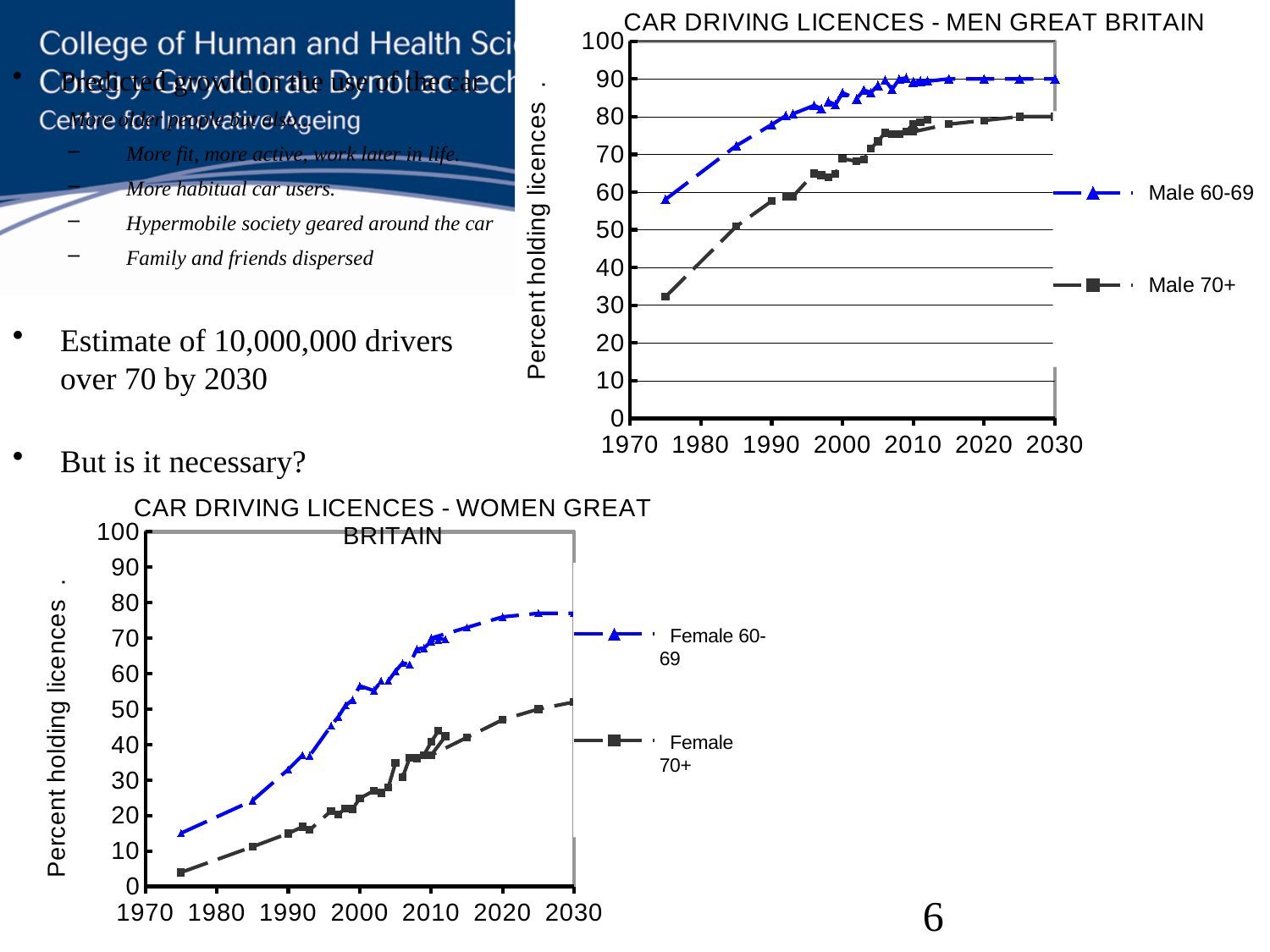
In the 'CAR DRIVING LICENCES - MEN GREAT BRITAIN' chart, is the value for Male 70+ in 1975 greater or less than 40? less In the 'CAR DRIVING LICENCES - MEN GREAT BRITAIN' chart, which series has the higher value in 2030, Male 60-69 or Male 70+? Male 60-69 What is the y-axis label of the 'CAR DRIVING LICENCES - WOMEN GREAT BRITAIN' chart? Percent holding licences In the 'CAR DRIVING LICENCES - WOMEN GREAT BRITAIN' chart, is the value for Female 60-69 in 2030 greater or less than 70? greater In the 'CAR DRIVING LICENCES - MEN GREAT BRITAIN' chart, is the value for Male 60-69 in 1975 greater or less than 50? greater In the 'CAR DRIVING LICENCES - WOMEN GREAT BRITAIN' chart, how many series does the legend list? 2 In the 'CAR DRIVING LICENCES - MEN GREAT BRITAIN' chart, does the Male 70+ series rise or fall from 1970 to 2030? rise What kind of chart is the 'CAR DRIVING LICENCES - MEN GREAT BRITAIN' chart? line chart In the 'CAR DRIVING LICENCES - MEN GREAT BRITAIN' chart, what are the two legend entries? Male 60-69 and Male 70+ In the 'CAR DRIVING LICENCES - MEN GREAT BRITAIN' chart, how many series does the legend list? 2